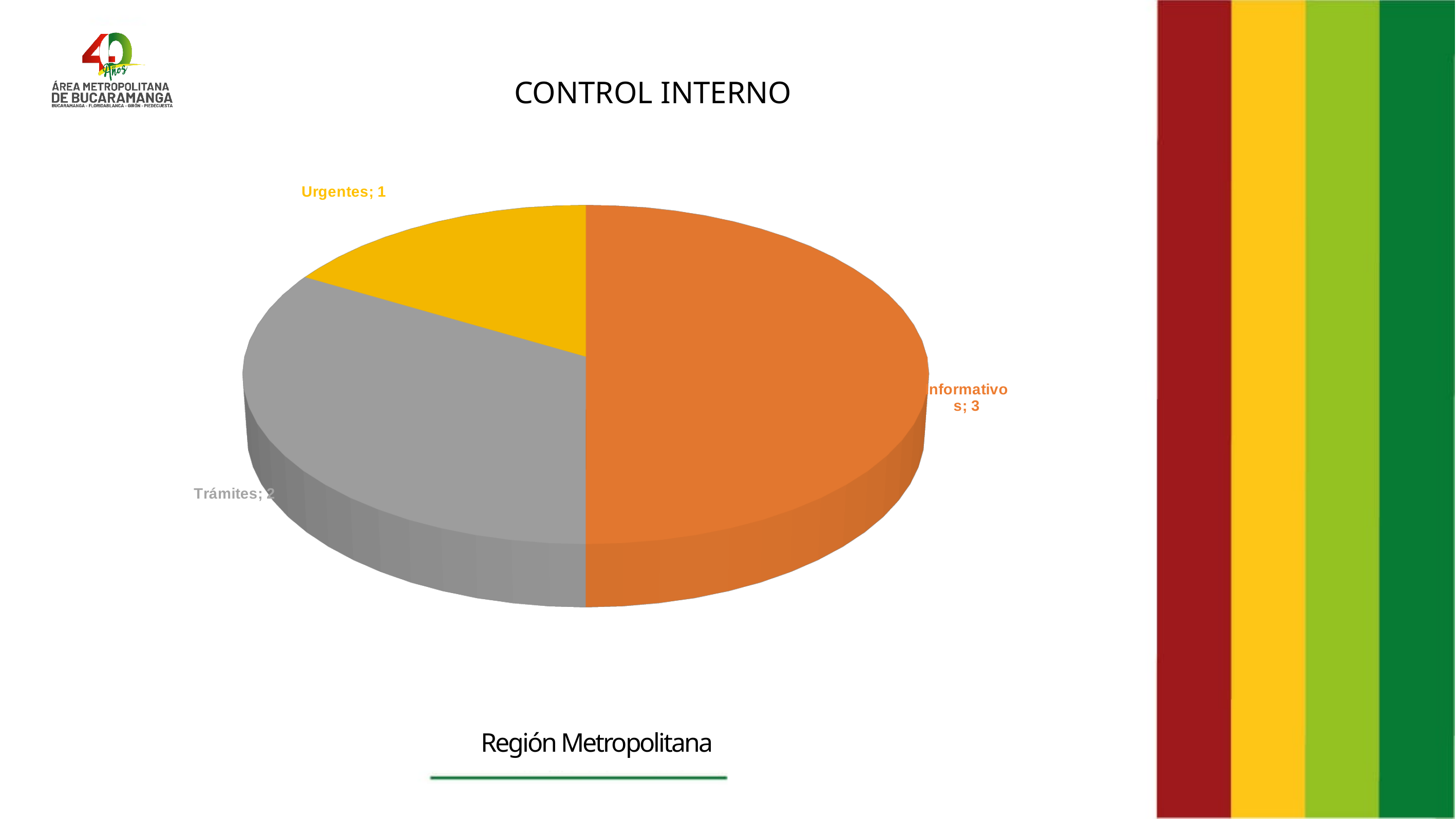
Which category has the smallest slice of the pie? Urgentes What is the title of the chart? CONTROL INTERNO What kind of chart is shown on the slide? Pie chart What is the difference between the values for Informativos and Urgentes? 2 Which is larger, the value for Trámites or the value for Urgentes? Trámites What is the value for Informativos? 3 What is the value for Urgentes? 1 Which category has the largest slice of the pie? Informativos What is the value for Trámites? 2 What is the total of all the slices in the pie chart? 6 What share of the pie does Informativos represent? 50% How many categories are shown in the pie chart? 3